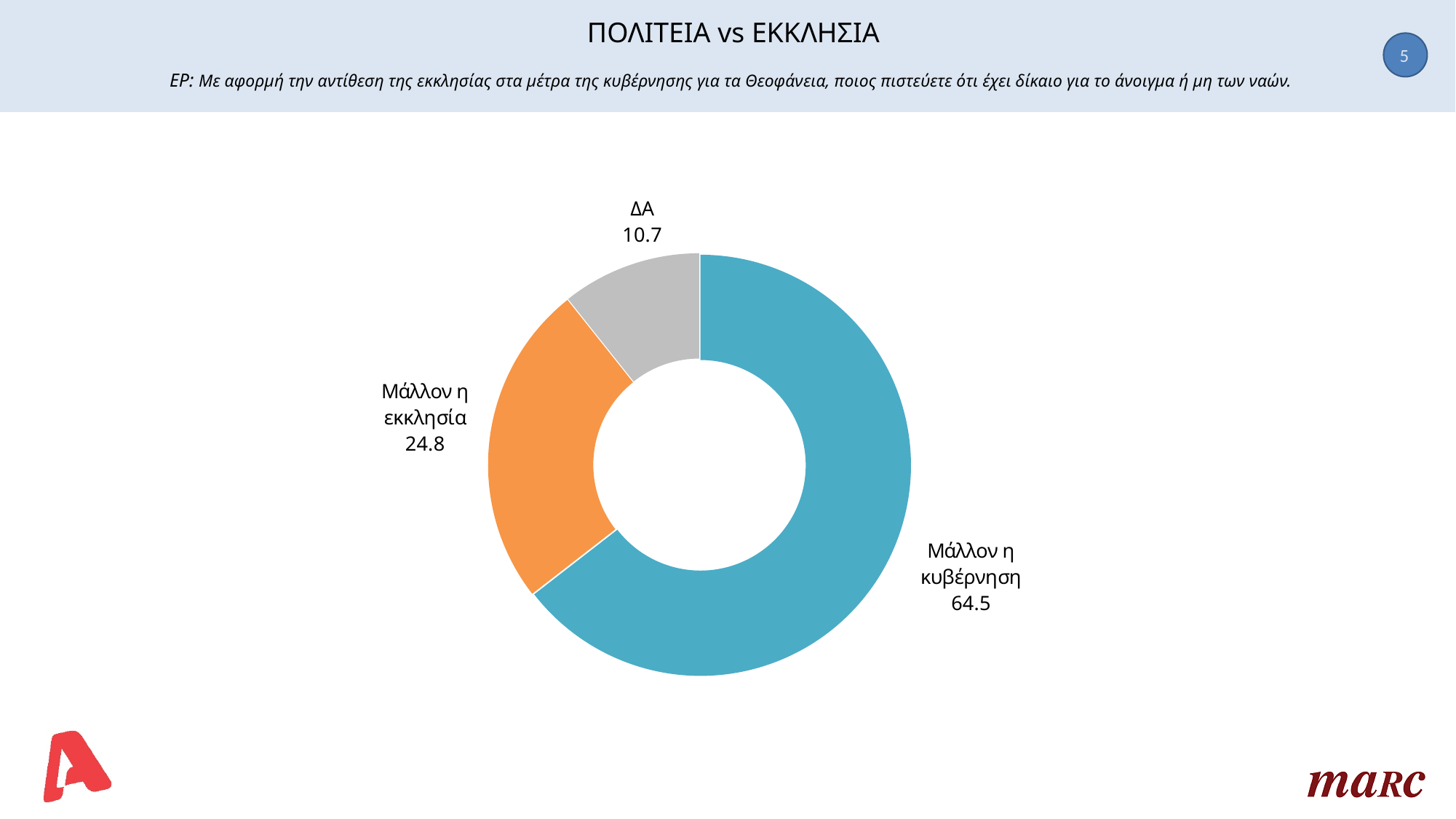
What is the difference between the values for "Μάλλον η εκκλησία" and "ΔΑ"? 14.1 What is the value for "Μάλλον η εκκλησία"? 24.8 Which is larger, the value for "Μάλλον η εκκλησία" or the value for "ΔΑ"? Μάλλον η εκκλησία What is the value for "Μάλλον η κυβέρνηση"? 64.5 What is the value for "ΔΑ"? 10.7 Which category has the largest slice? Μάλλον η κυβέρνηση What is the difference between the values for "Μάλλον η κυβέρνηση" and "Μάλλον η εκκλησία"? 39.7 How many categories does the chart show? 3 Which category has the smallest slice? ΔΑ What is the title of the slide? ΠΟΛΙΤΕΙΑ vs ΕΚΚΛΗΣΙΑ What kind of chart is shown on the slide? Doughnut (pie) chart What colour is the slice for "Μάλλον η εκκλησία"? Orange